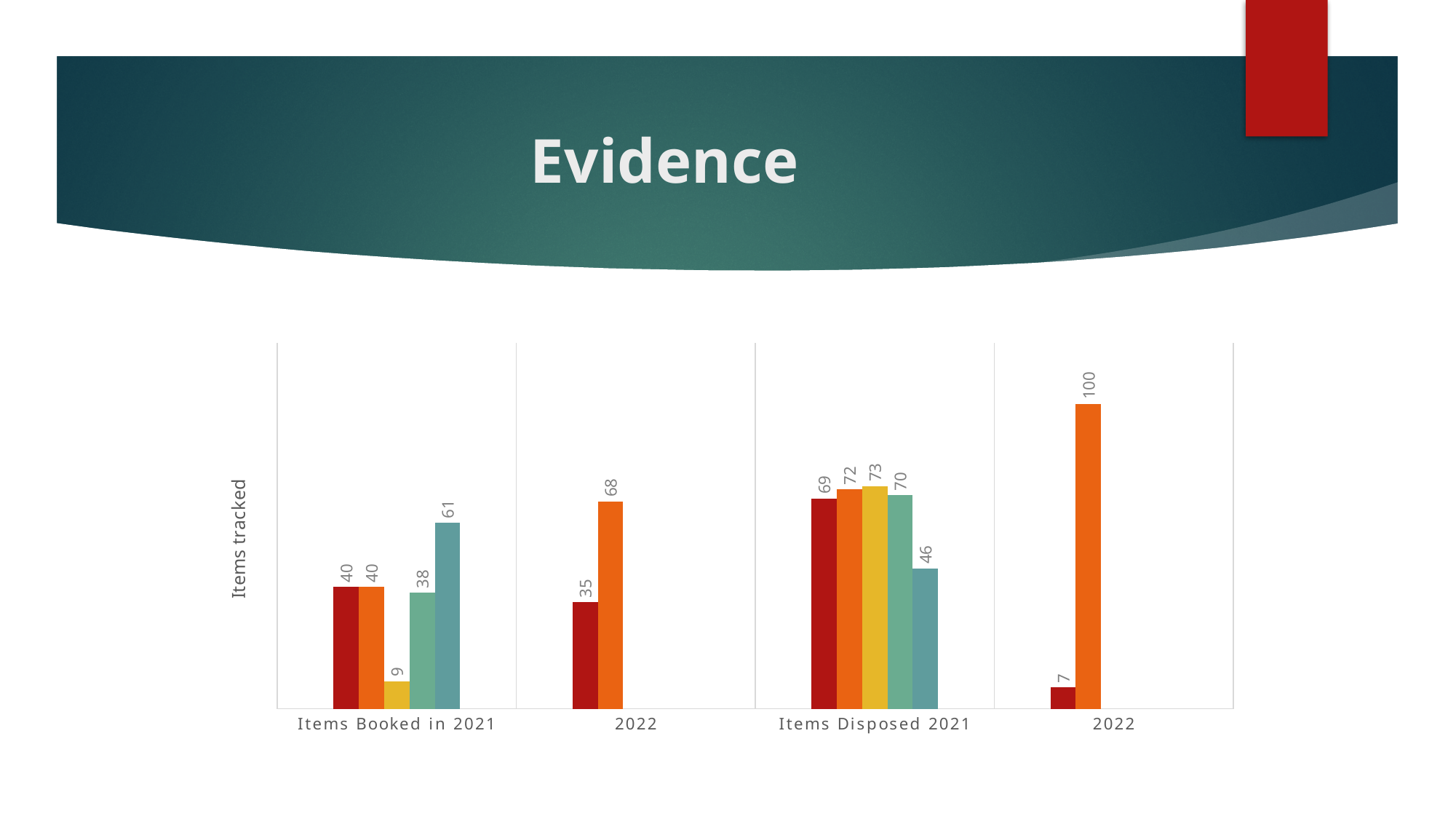
What is the value of the teal (rightmost) bar in the Items Booked in 2021 category? 61 What is the title of the vertical axis? Items tracked What is the lowest value shown anywhere on the chart? 7 How many bars are plotted in the Items Disposed 2021 category? 5 Which category has the larger yellow bar: Items Booked in 2021 or Items Disposed 2021? Items Disposed 2021 How many categories are labelled along the x axis of the chart? 4 In the rightmost 2022 category, what is the difference between the orange bar and the dark red bar? 93 What is the value of the dark red bar in the 2022 category immediately to the right of Items Booked in 2021? 35 What kind of chart is shown on the slide? bar chart What is the value of the yellow bar in the Items Booked in 2021 category? 9 In the Items Disposed 2021 category, what is the difference between the orange bar and the dark red bar? 3 What is the highest value shown anywhere on the chart? 100